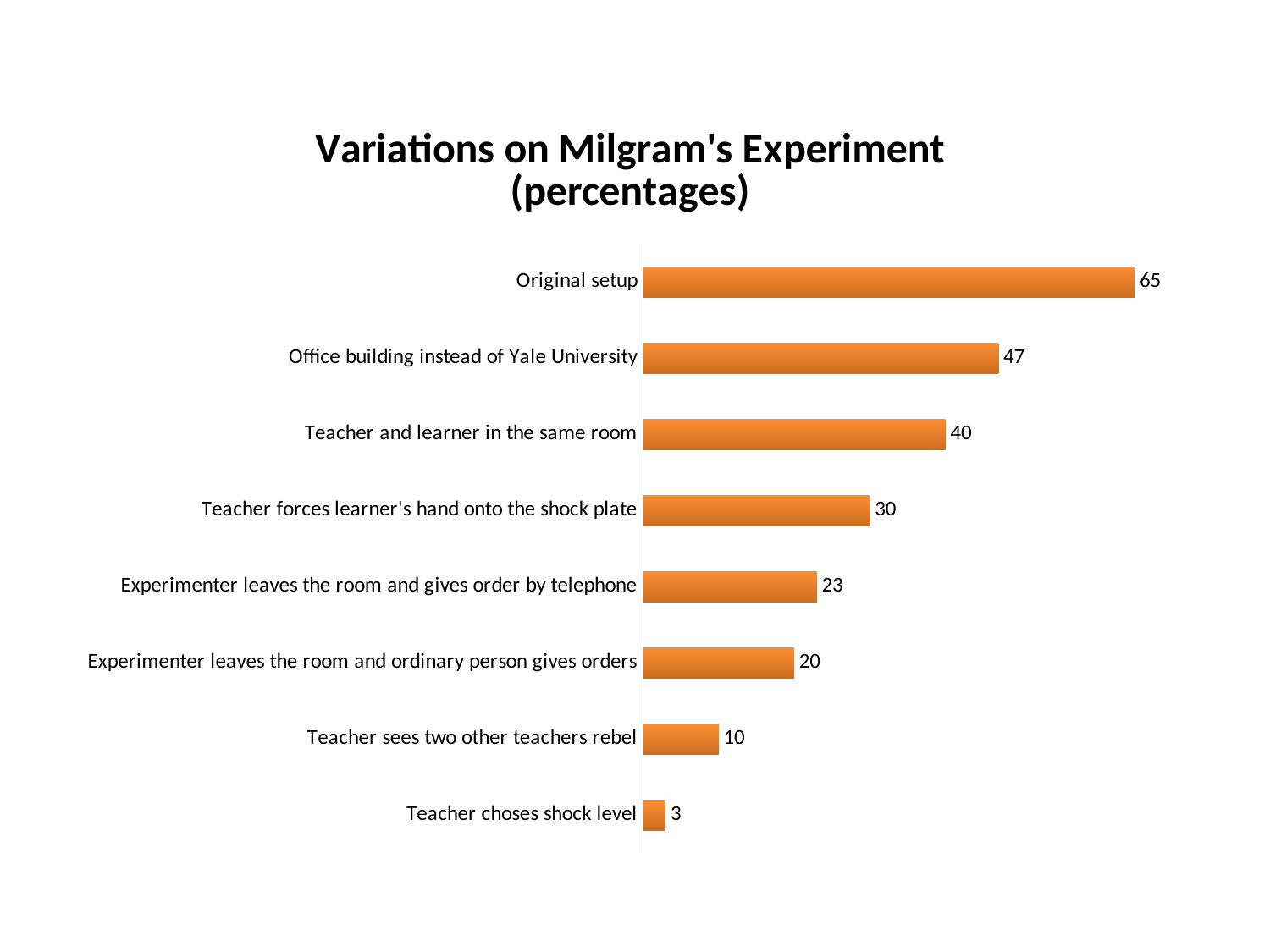
How many categories are shown in the chart? 8 What kind of chart is shown on the slide? Bar chart Which is larger: Experimenter leaves the room and ordinary person gives orders or Teacher sees two other teachers rebel? Experimenter leaves the room and ordinary person gives orders What is the value for Original setup? 65 What is the value for Teacher choses shock level? 3 Which category has the highest value? Original setup What is the difference between Original setup and Office building instead of Yale University? 18 What is the value for Teacher and learner in the same room? 40 What is the difference between Teacher forces learner's hand onto the shock plate and Teacher sees two other teachers rebel? 20 What is the title of the chart? Variations on Milgram's Experiment (percentages) What is the value for Experimenter leaves the room and gives order by telephone? 23 Which category has the lowest value? Teacher choses shock level